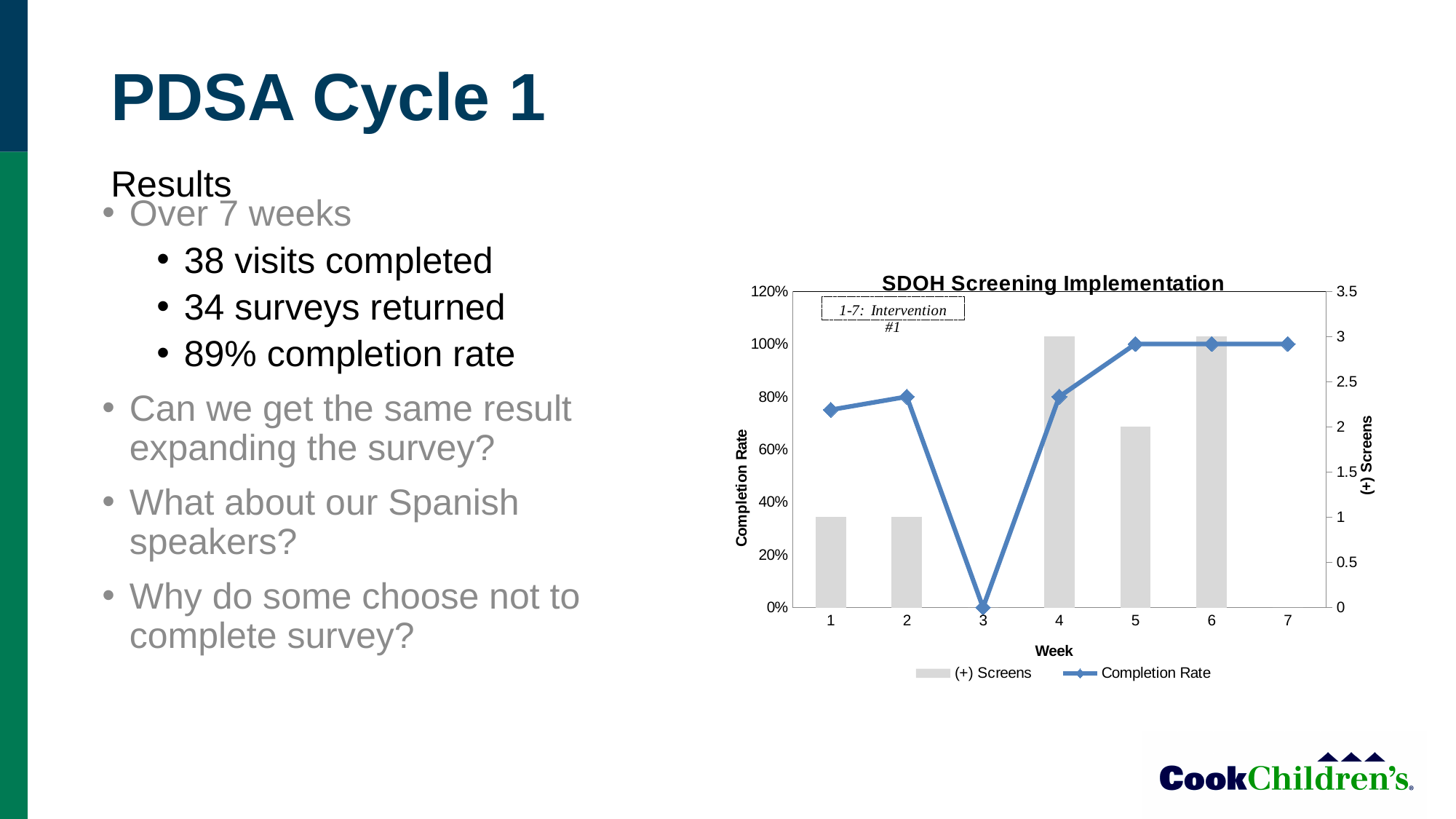
Which week has the lowest Completion Rate on the SDOH Screening Implementation chart? Week 3 What is the Completion Rate in week 3 on the SDOH Screening Implementation chart? 0% Is the (+) Screens value for week 1 greater or less than 2? less Which week has the larger (+) Screens value, week 4 or week 5? Week 4 What is the title of the chart on the slide? SDOH Screening Implementation What is the label of the right-hand (secondary) vertical axis on the chart? (+) Screens How many series does the legend of the SDOH Screening Implementation chart list? 2 How many weeks are shown on the x axis of the SDOH Screening Implementation chart? 7 Does the Completion Rate rise or fall from week 4 to week 5? Rises Is the (+) Screens value for week 5 greater or less than 1.5? greater Is the Completion Rate for week 1 greater or less than 60%? greater What kind of chart is the SDOH Screening Implementation chart? A combined bar and line chart